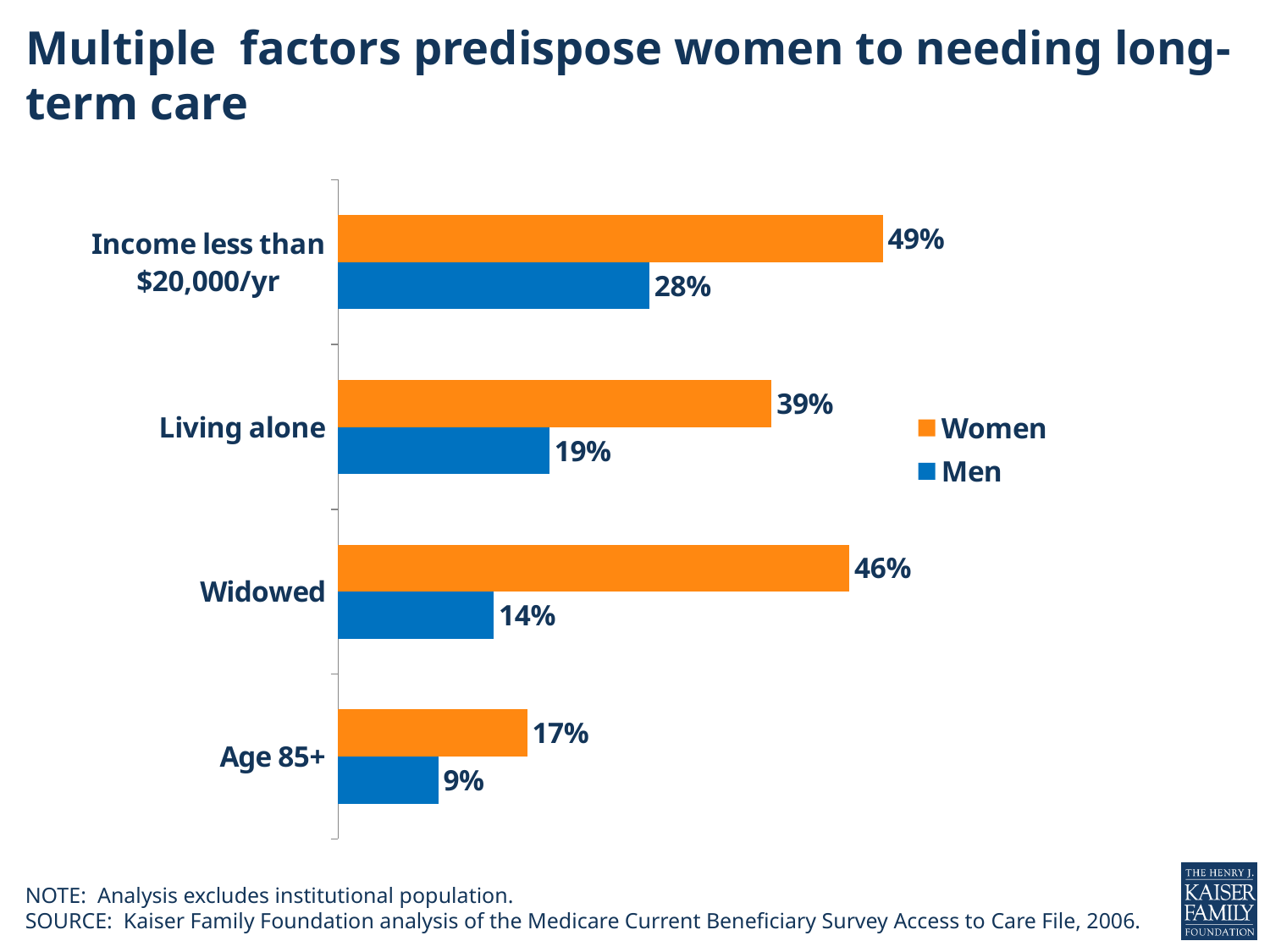
How many series does the legend list? 2 What is the difference between women and men for Income less than $20,000/yr? 21% What kind of chart is shown on the slide? Bar chart What is the value for women in the Age 85+ category? 17% Which category has the lowest value for men? Age 85+ What is the value for men in the Living alone category? 19% Which category has the highest value for women? Income less than $20,000/yr In the Living alone category, which is larger, the value for women or for men? Women What is the difference between women and men in the Widowed category? 32% What percentage of women have income less than $20,000/yr? 49% How many categories are shown on the chart? 4 What percentage of men are widowed? 14%